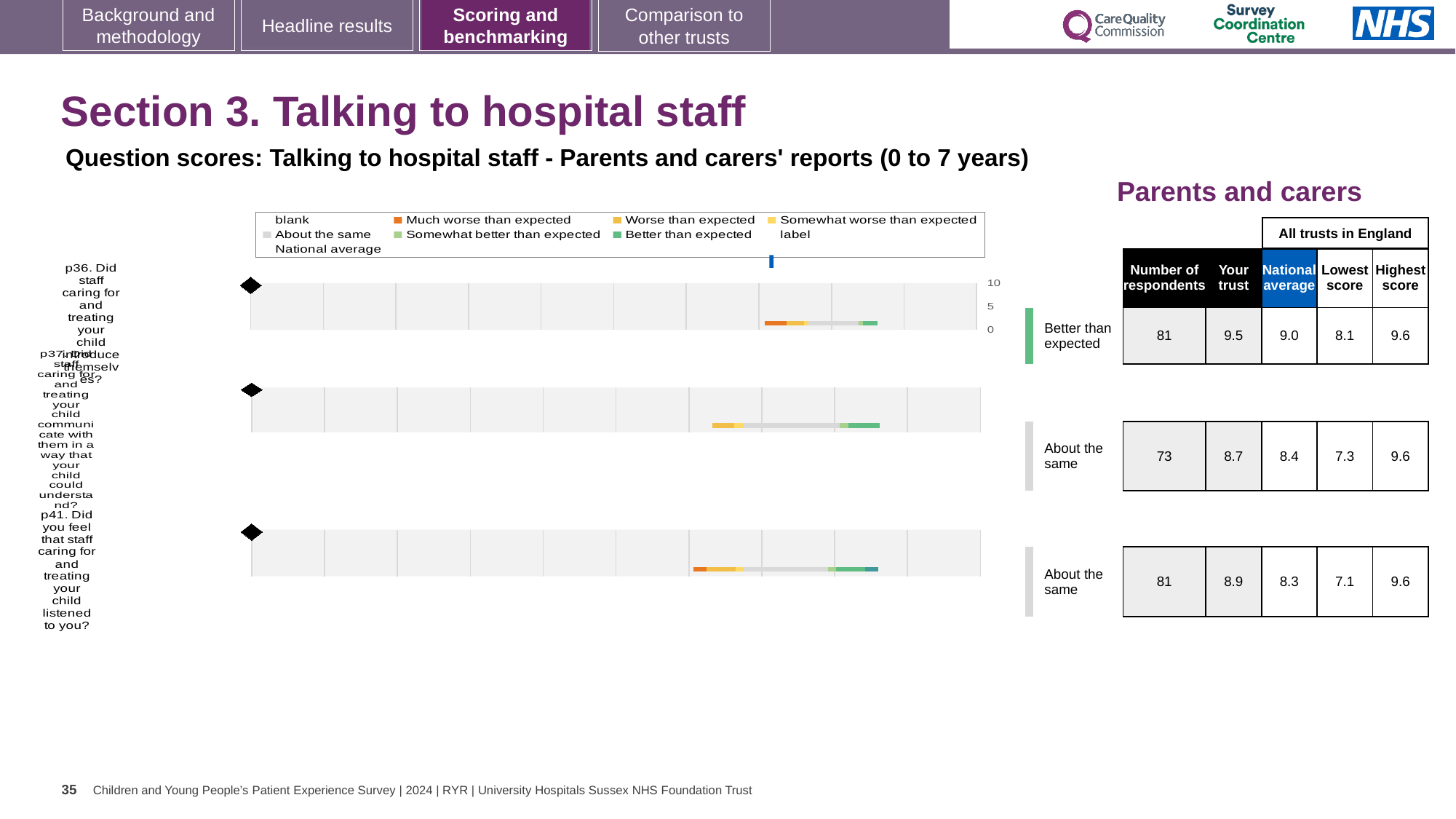
In the table next to the chart, which row has the lowest 'Lowest score'? the third row (7.1) What colour does the legend use for 'Much worse than expected'? orange In the table next to the chart, what is the national average for the third row? 8.3 In the table next to the chart, what is the 'Your trust' score for the first row (Better than expected)? 9.5 How many entries does the chart legend list? 9 In the table next to the chart, what is the difference between 'Your trust' and 'National average' in the first row? 0.5 In the table next to the chart, is the 'Your trust' score in the second row larger or smaller than the national average? larger In the table next to the chart, what is the number of respondents for the second row (About the same)? 73 How many questions (categories) are plotted in the chart? 3 What kind of chart is shown on the slide? bar chart What is the highest value shown on the chart's axis? 10